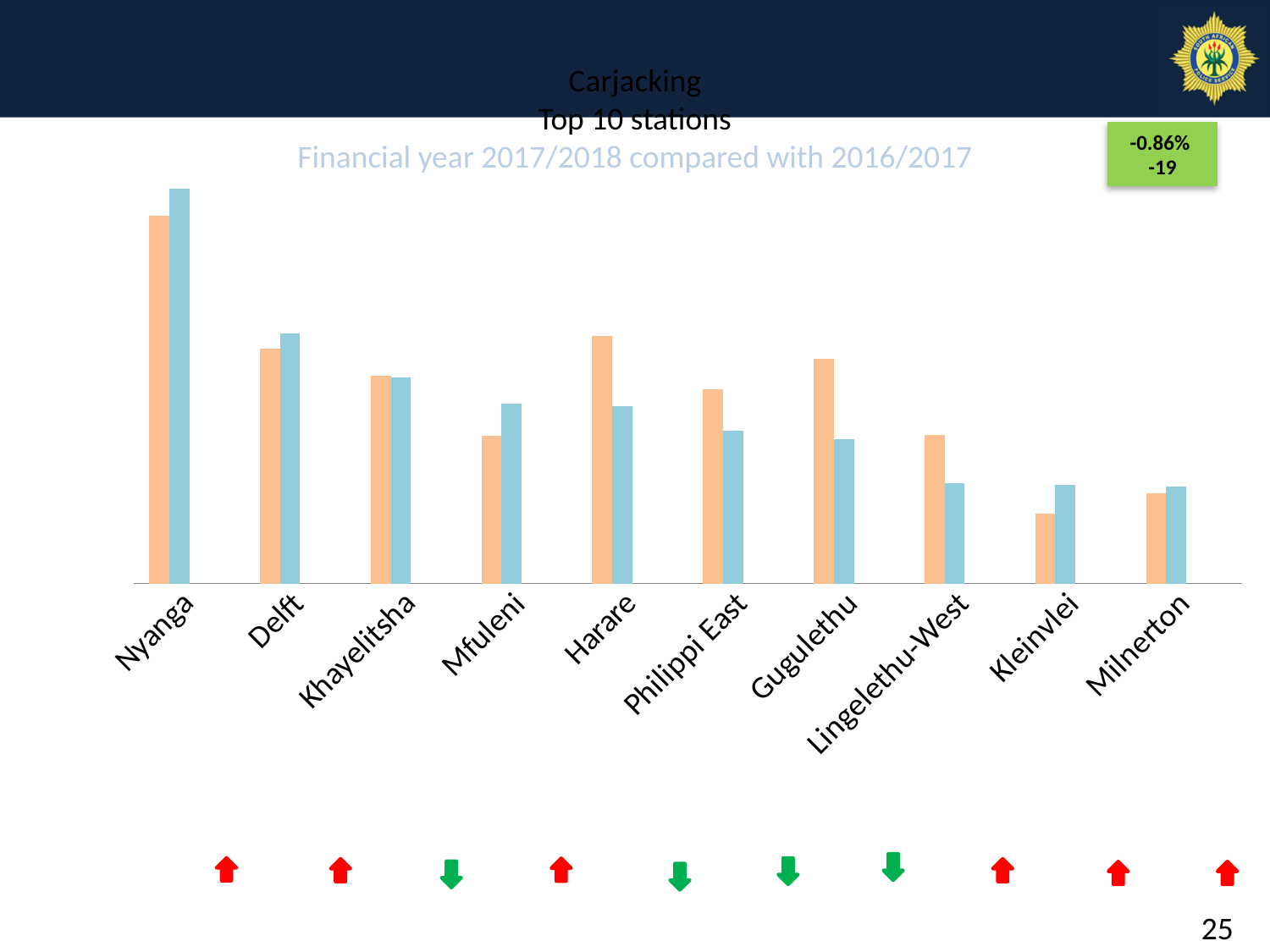
What kind of chart is shown on the slide? bar chart Which station has the shortest orange bar in the chart? Kleinvlei Which crime type does the chart title say the chart is about? Carjacking Which two financial years does the chart subtitle say are compared? 2017/2018 and 2016/2017 Which station has the tallest bars in the chart? Nyanga How many stations are shown on the x axis of the chart? 10 For Gugulethu, which bar is taller, the orange bar or the blue bar? orange How many bars are plotted for each station in the chart? 2 For Harare, which bar is taller, the orange bar or the blue bar? orange For Mfuleni, which bar is taller, the orange bar or the blue bar? blue